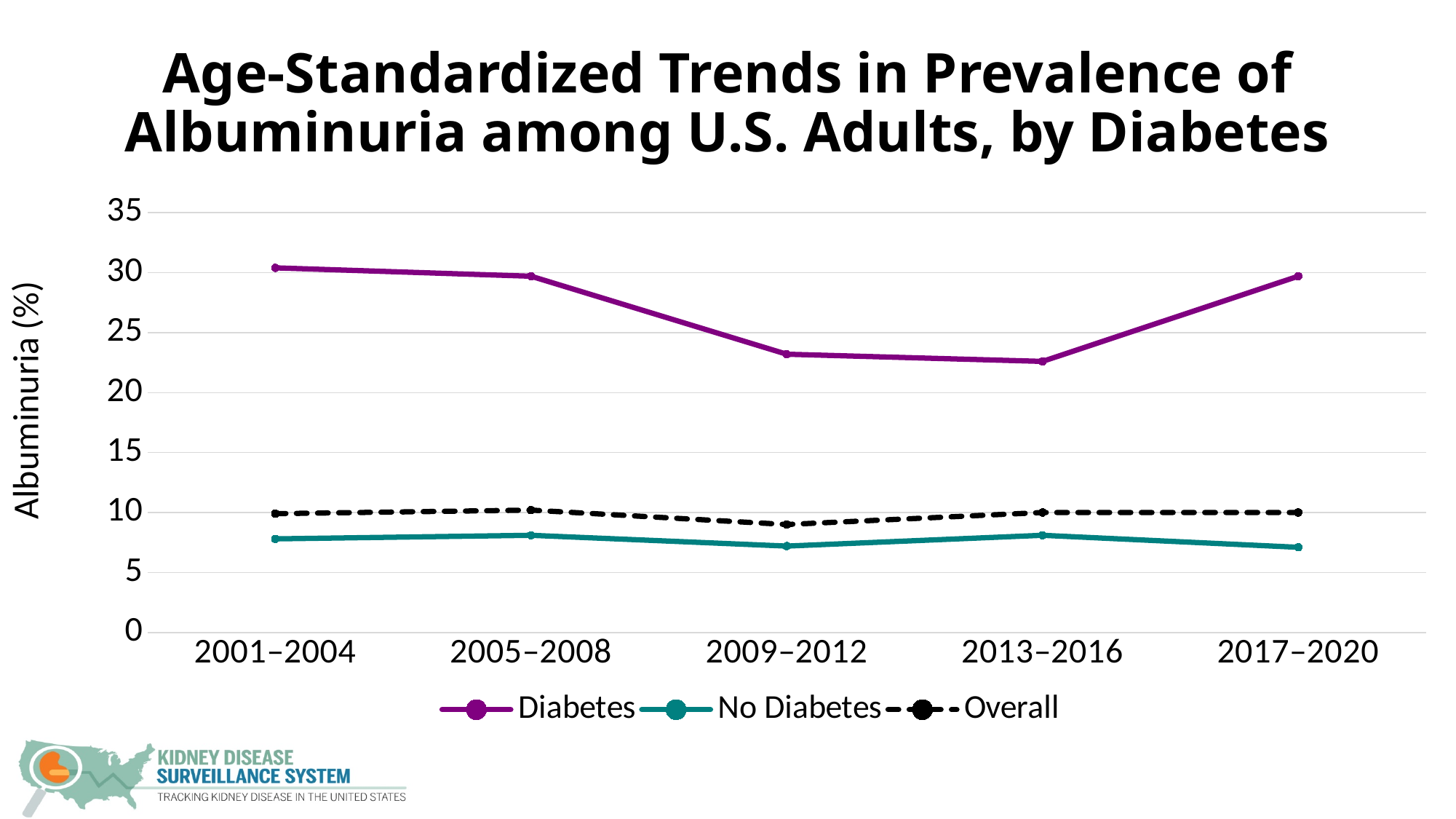
What is the label on the y axis? Albuminuria (%) What kind of chart is shown on the slide? line chart Which series has the highest values across all periods? Diabetes Which is larger for 2017–2020: the Diabetes value or the No Diabetes value? Diabetes Which is larger for the Diabetes series: the value for 2009–2012 or the value for 2017–2020? 2017–2020 Is the Diabetes value for 2013–2016 greater or less than 20? greater Is the Overall value for 2009–2012 greater or less than 10? less Is the No Diabetes value for 2017–2020 greater or less than 10? less How many time periods are shown on the x axis? 5 How many series does the legend list? 3 Does the Diabetes series rise or fall from 2001–2004 to 2013–2016? fall